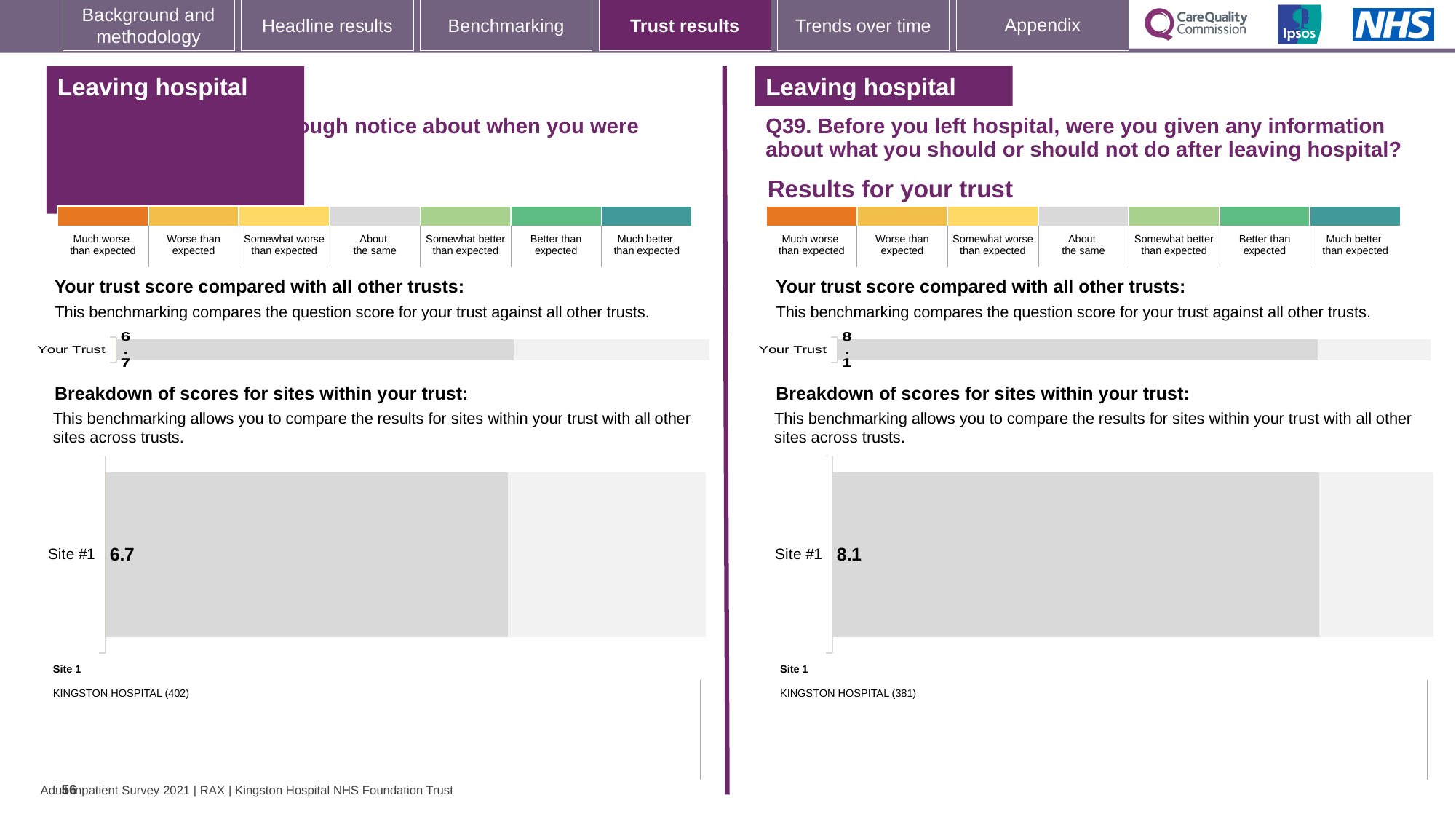
On the right-hand (Q39) 'Your trust score compared with all other trusts' chart, what is the value shown for Your Trust? 8.1 What is the difference between the Site #1 value on the right-hand (Q39) site breakdown chart and the Site #1 value on the left-hand site breakdown chart? 1.4 Which is larger: the Site #1 value on the left-hand site breakdown chart or the Site #1 value on the right-hand (Q39) site breakdown chart? The right-hand (Q39) chart How many bars are plotted on the left-hand 'Your trust score compared with all other trusts' chart? 1 On the right-hand (Q39) 'Breakdown of scores for sites within your trust' chart, what is the value shown for Site #1? 8.1 On the left-hand 'Breakdown of scores for sites within your trust' chart, what is the value shown for Site #1? 6.7 What kind of chart is the right-hand (Q39) 'Breakdown of scores for sites within your trust' chart? Bar chart What kind of chart is the left-hand 'Your trust score compared with all other trusts' chart? Bar chart Which site is listed as Site 1 beneath the right-hand (Q39) site breakdown chart? KINGSTON HOSPITAL (381) How many sites are plotted on the right-hand (Q39) 'Breakdown of scores for sites within your trust' chart? 1 On the left-hand 'Your trust score compared with all other trusts' chart, what is the value shown for Your Trust? 6.7 Which site is listed as Site 1 beneath the left-hand site breakdown chart? KINGSTON HOSPITAL (402)